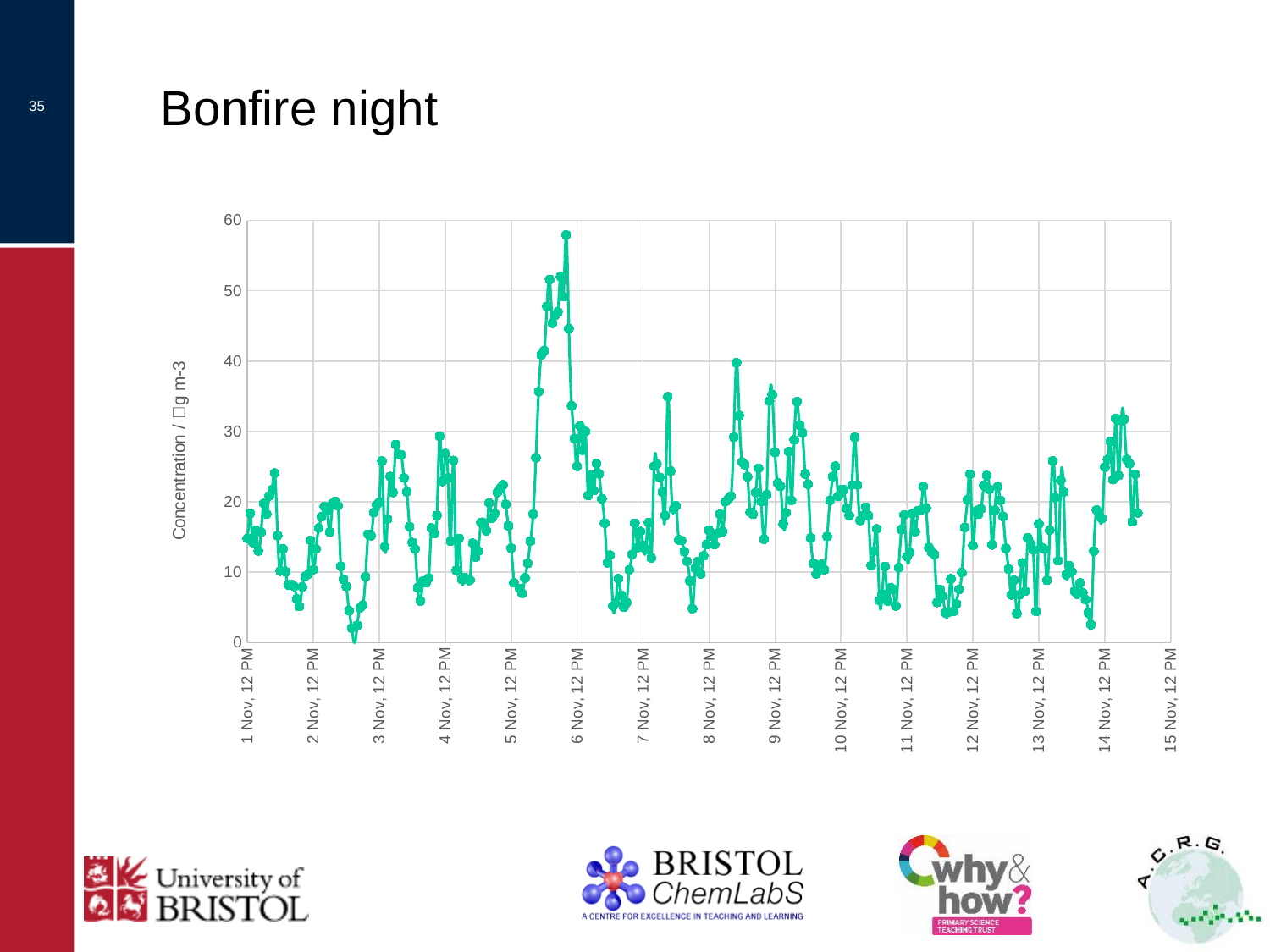
Is the concentration at 1 Nov, 12 PM greater or less than 20? less Which is larger: the peak concentration near 6 Nov, 12 PM or the peak concentration near 9 Nov, 12 PM? near 6 Nov, 12 PM Is the highest concentration value on the chart greater or less than 50? greater What is the highest value shown on the y axis of the chart? 60 Does the highest peak on the chart occur closer to 6 Nov, 12 PM or to 13 Nov, 12 PM? 6 Nov, 12 PM Which is larger: the peak concentration between 8 Nov and 9 Nov or the peak concentration between 11 Nov and 12 Nov? between 8 Nov and 9 Nov What is the title of the slide containing the chart? Bonfire night Is the lowest concentration value on the chart greater or less than 5? less How many date labels are shown along the x axis of the chart? 15 What kind of chart is shown on the slide? line chart